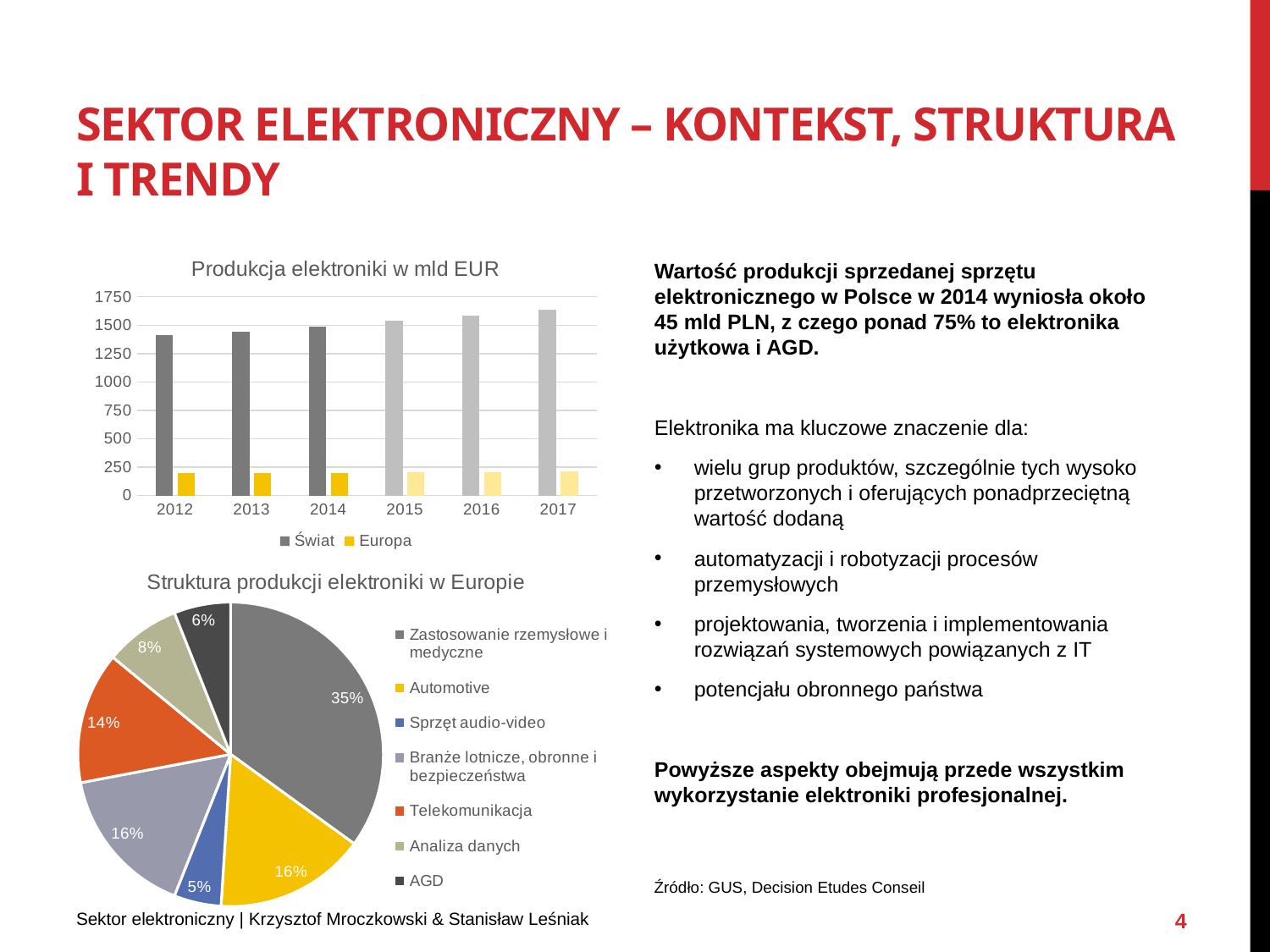
What type of chart is 'Produkcja elektroniki w mld EUR'? bar chart In the 'Produkcja elektroniki w mld EUR' chart, do the Świat values rise or fall from 2012 to 2017? rise In the 'Produkcja elektroniki w mld EUR' chart, is the Świat value for 2017 greater or less than 1500? greater In the 'Struktura produkcji elektroniki w Europie' pie chart, what is the difference between the shares of Automotive and Sprzęt audio-video? 11% In the 'Produkcja elektroniki w mld EUR' chart, which series has the larger value in 2015, Świat or Europa? Świat What type of chart is 'Struktura produkcji elektroniki w Europie'? pie chart In the 'Struktura produkcji elektroniki w Europie' pie chart, what share does Telekomunikacja have? 14% How many years are shown on the x axis of the 'Produkcja elektroniki w mld EUR' chart? 6 In the 'Produkcja elektroniki w mld EUR' chart, is the Europa value for 2012 greater or less than 250? less In the 'Produkcja elektroniki w mld EUR' chart, is the Świat value for 2012 greater or less than 1250? greater In the 'Struktura produkcji elektroniki w Europie' pie chart, which category has the largest share? Zastosowanie rzemysłowe i medyczne How many series does the legend of the 'Produkcja elektroniki w mld EUR' chart list? 2